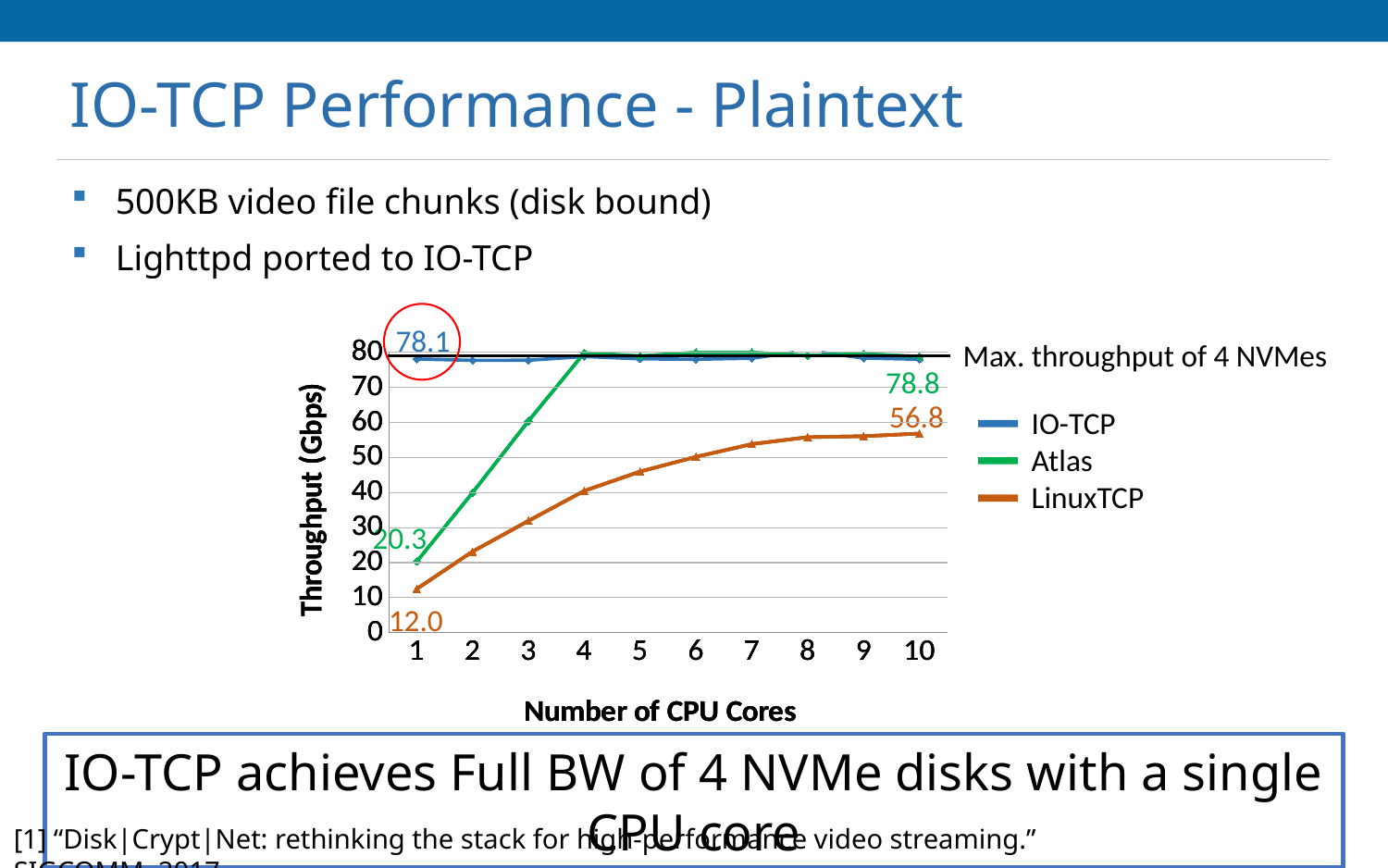
What is the throughput of LinuxTCP with 1 CPU core? 12.0 Is the LinuxTCP throughput at 5 CPU cores greater or less than 40? greater Which series has the highest throughput at 1 CPU core? IO-TCP What type of chart is shown on the slide? line chart What is the throughput of IO-TCP with 1 CPU core? 78.1 Which series has the lowest throughput at 1 CPU core? LinuxTCP What is the difference between the IO-TCP and LinuxTCP throughput at 1 CPU core? 66.1 How does the LinuxTCP throughput change as the number of CPU cores increases from 1 to 10? It rises What is the label of the y axis? Throughput (Gbps) How many series does the chart legend list? 3 What is the throughput of LinuxTCP with 10 CPU cores? 56.8 What is the throughput of Atlas with 1 CPU core? 20.3